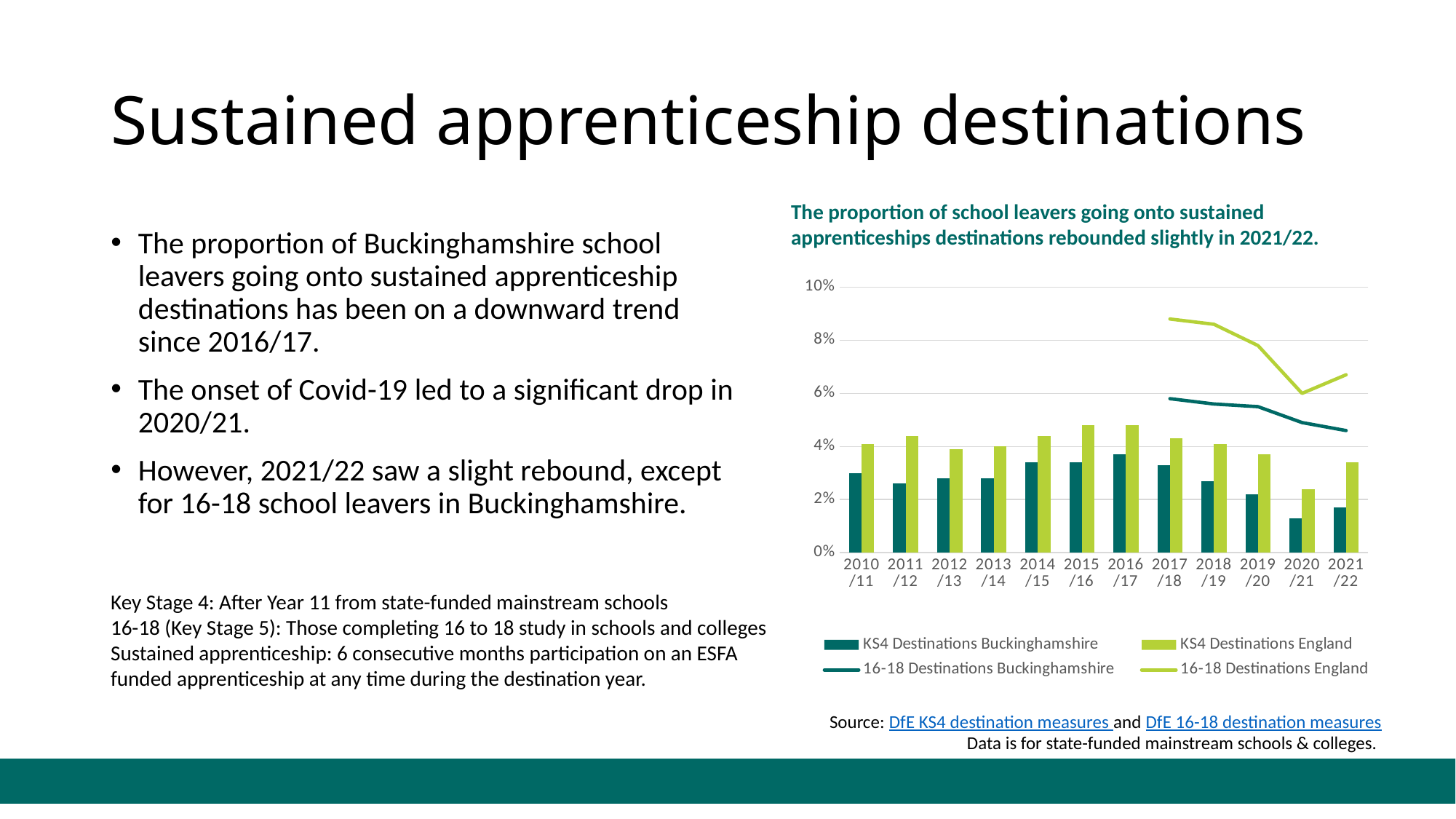
How many series does the chart legend list? 4 How many academic years are shown on the x axis of the chart? 12 Does the 16-18 Destinations England line rise or fall between 2017/18 and 2020/21? Fall Is the value for KS4 Destinations Buckinghamshire in 2020/21 greater or less than 2%? less What kind of chart is shown on the slide? A combined bar and line chart Which two series are plotted as lines rather than bars? 16-18 Destinations Buckinghamshire and 16-18 Destinations England In which year is the 16-18 Destinations England line at its highest point? 2017/18 In which year is the KS4 Destinations England bar lowest? 2020/21 In 2021/22, which is larger: KS4 Destinations England or KS4 Destinations Buckinghamshire? KS4 Destinations England Is the value for 16-18 Destinations England in 2017/18 greater or less than 8%? greater In which year is the KS4 Destinations Buckinghamshire bar highest? 2016/17 In which year is the KS4 Destinations Buckinghamshire bar lowest? 2020/21